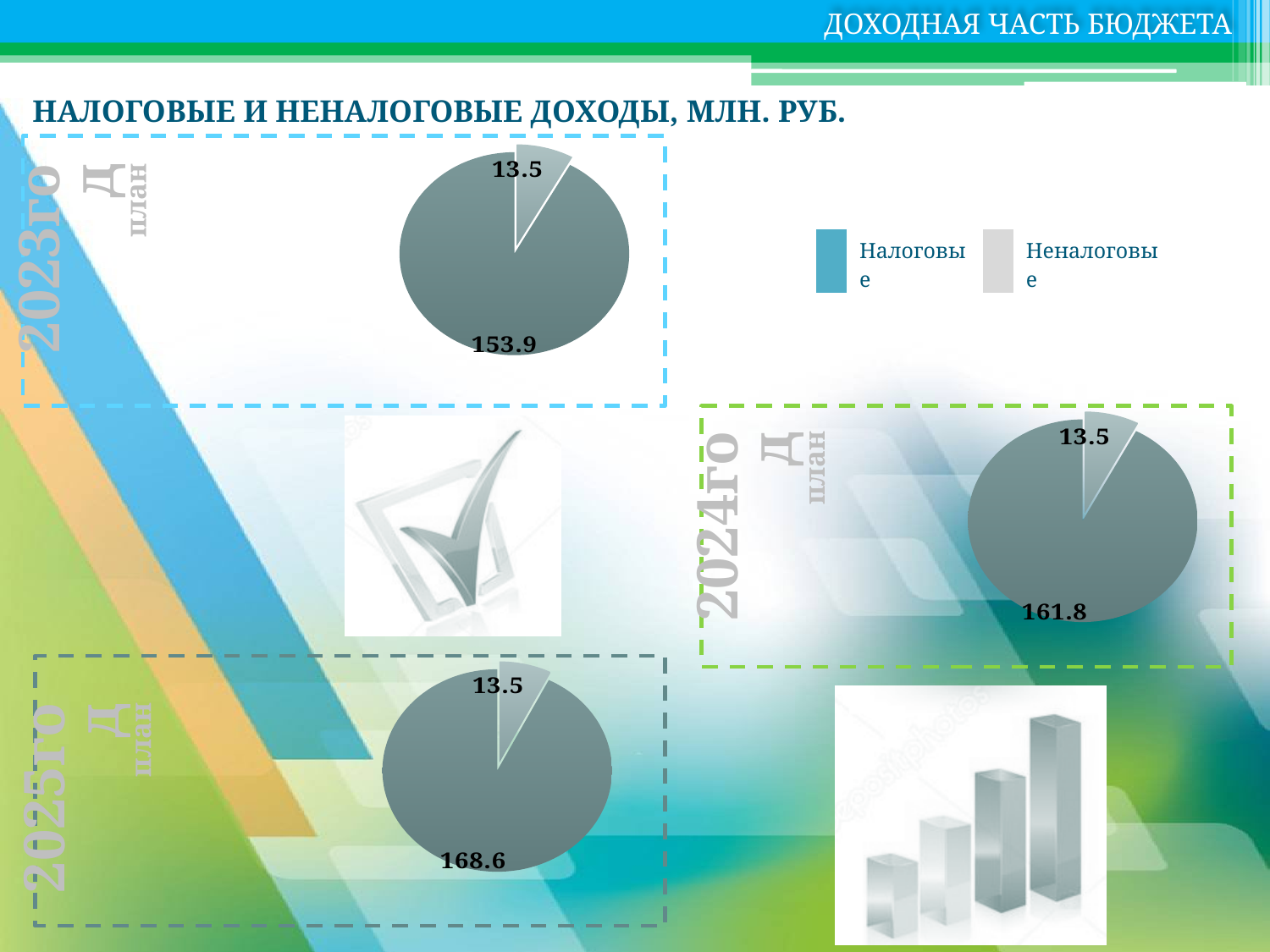
What is the total of the two slices in the 2024 план pie chart? 175.3 What is the difference between the Налоговые value in the 2025 план pie chart and the Налоговые value in the 2023 план pie chart? 14.7 In the 2024 план pie chart, what is the value of the larger slice (Налоговые)? 161.8 What type of chart is used to show the 2023 план data? pie chart In the 2024 план pie chart, which slice is larger, Налоговые or Неналоговые? Налоговые How many pie charts are shown on the slide? 3 What are the two legend entries on the slide? Налоговые, Неналоговые In the 2025 план pie chart, what is the value of the smaller slice (Неналоговые)? 13.5 In the 2025 план pie chart, what is the value of the larger slice (Налоговые)? 168.6 Across the three pie charts, does the Налоговые value rise or fall from 2023 to 2025? rise In the 2023 план pie chart, what is the value of the larger slice (Налоговые)? 153.9 How many entries does the legend list? 2